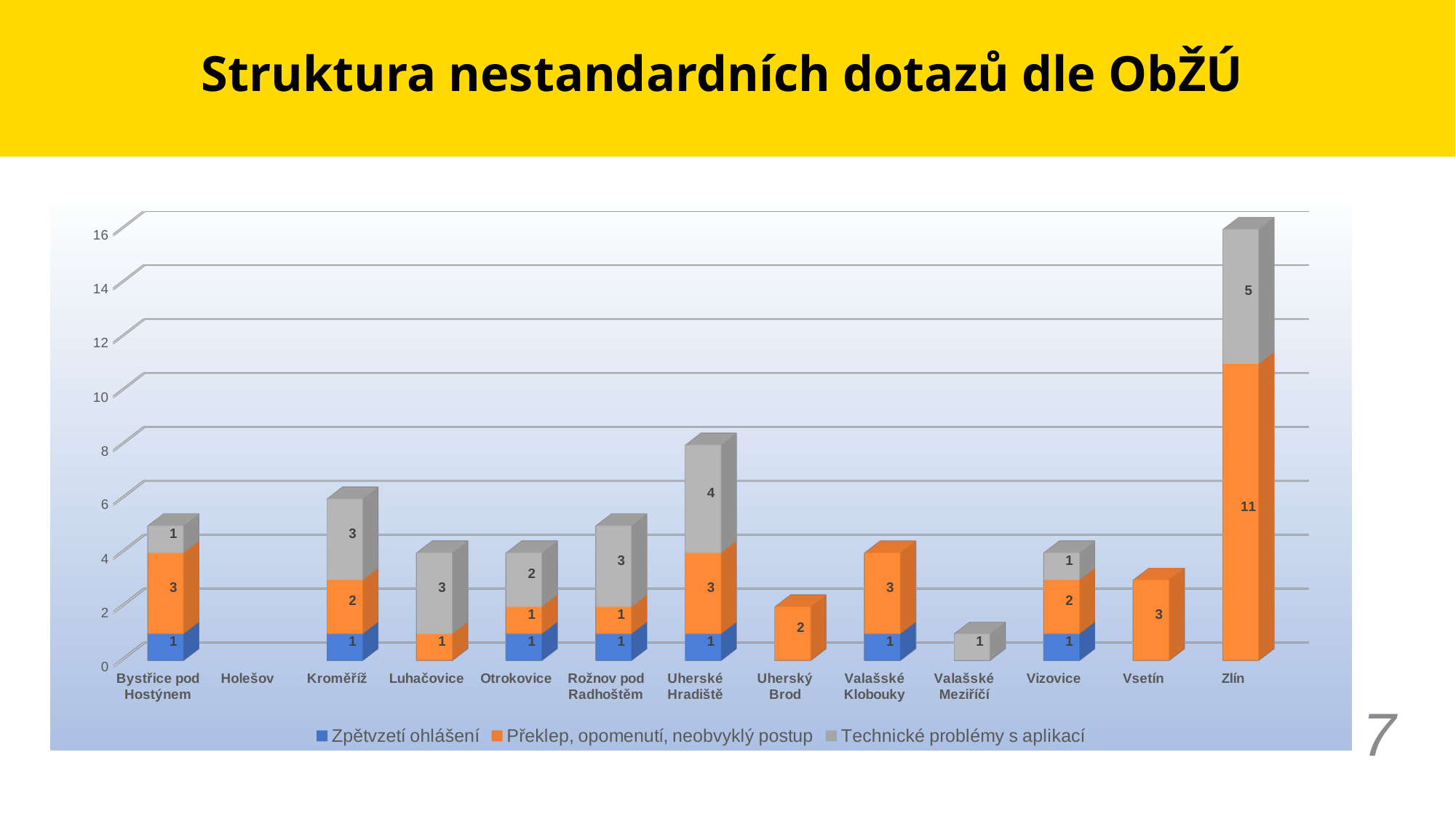
What is the difference between the 'Technické problémy s aplikací' values for Zlín and Kroměříž? 2 What is the value of 'Překlep, opomenutí, neobvyklý postup' for Zlín? 11 Which is larger: the 'Překlep, opomenutí, neobvyklý postup' value for Vsetín or for Uherský Brod? Vsetín What is the total of the stacked bar for Zlín? 16 What is the total of the stacked bar for Uherské Hradiště? 8 What is the value of 'Zpětvzetí ohlášení' for Kroměříž? 1 What is the title of the chart? Struktura nestandardních dotazů dle ObŽÚ Which category has the highest total stacked value? Zlín What is the value of 'Technické problémy s aplikací' for Uherské Hradiště? 4 What kind of chart is shown on the slide? Stacked bar chart How many series does the legend list? 3 How many categories are shown on the x axis? 13